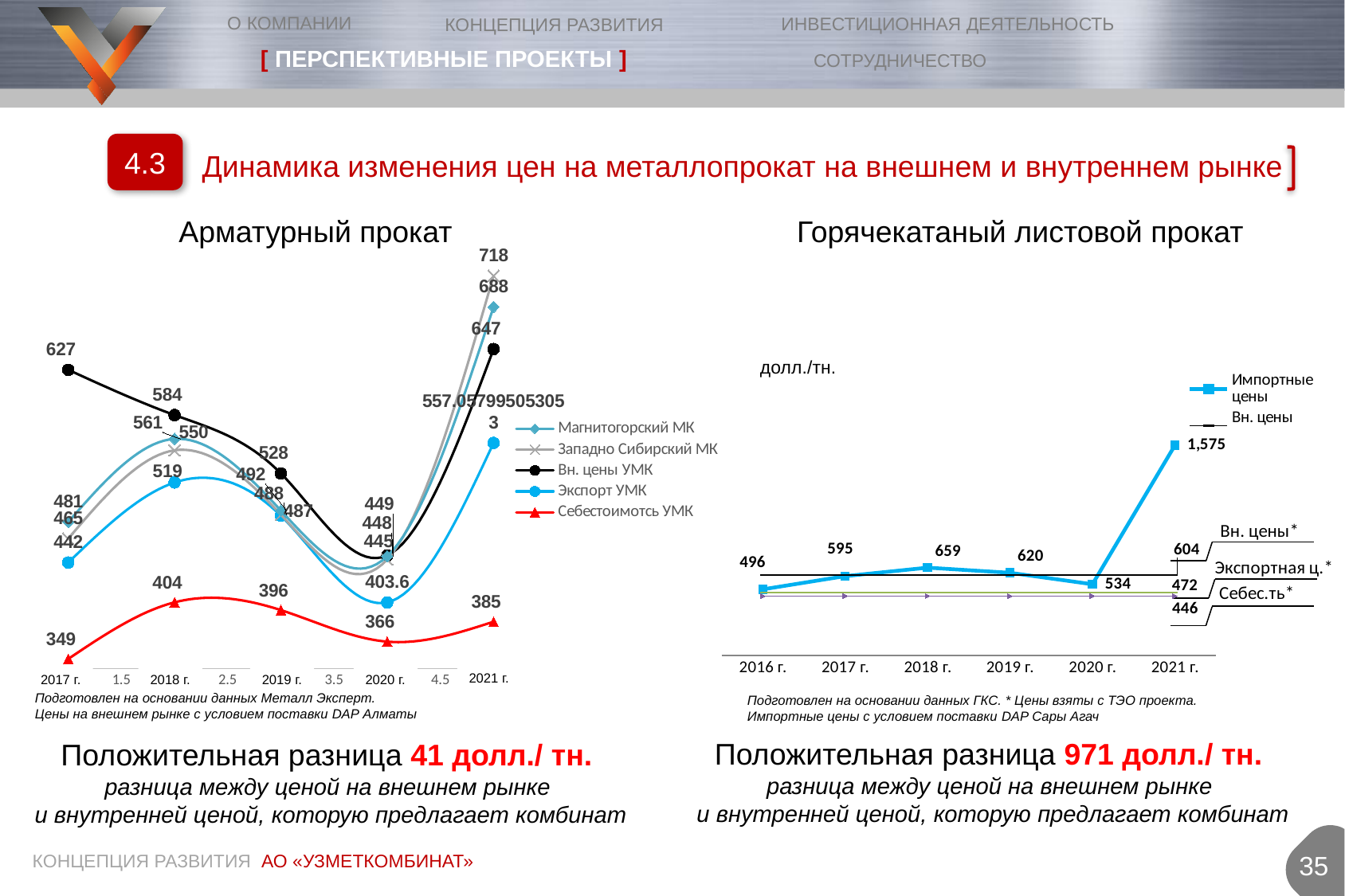
In the 'Арматурный прокат' chart, what is the value of 'Себестоимотсь УМК' for 2017 г.? 349 In the 'Горячекатаный листовой прокат' chart, what is the difference between 'Импортные цены' in 2018 г. and 2017 г.? 64 What kind of chart is the 'Арматурный прокат' chart? line chart In the 'Горячекатаный листовой прокат' chart, how many years are shown on the x axis? 6 In the 'Горячекатаный листовой прокат' chart, what is the value of 'Импортные цены' for 2021 г.? 1,575 In the 'Арматурный прокат' chart, what is the value of 'Вн. цены УМК' for 2017 г.? 627 In the 'Горячекатаный листовой прокат' chart, in which year are 'Импортные цены' highest? 2021 г. In the 'Арматурный прокат' chart, does 'Себестоимотсь УМК' rise or fall from 2019 г. to 2020 г.? fall How many series does the legend of the 'Арматурный прокат' chart list? 5 In the 'Горячекатаный листовой прокат' chart, which year has the higher 'Импортные цены' value, 2018 г. or 2019 г.? 2018 г. In the 'Арматурный прокат' chart, what is the difference between 'Себестоимотсь УМК' in 2018 г. and 2017 г.? 55 In the 'Арматурный прокат' chart, in which year is 'Себестоимотсь УМК' highest? 2018 г.